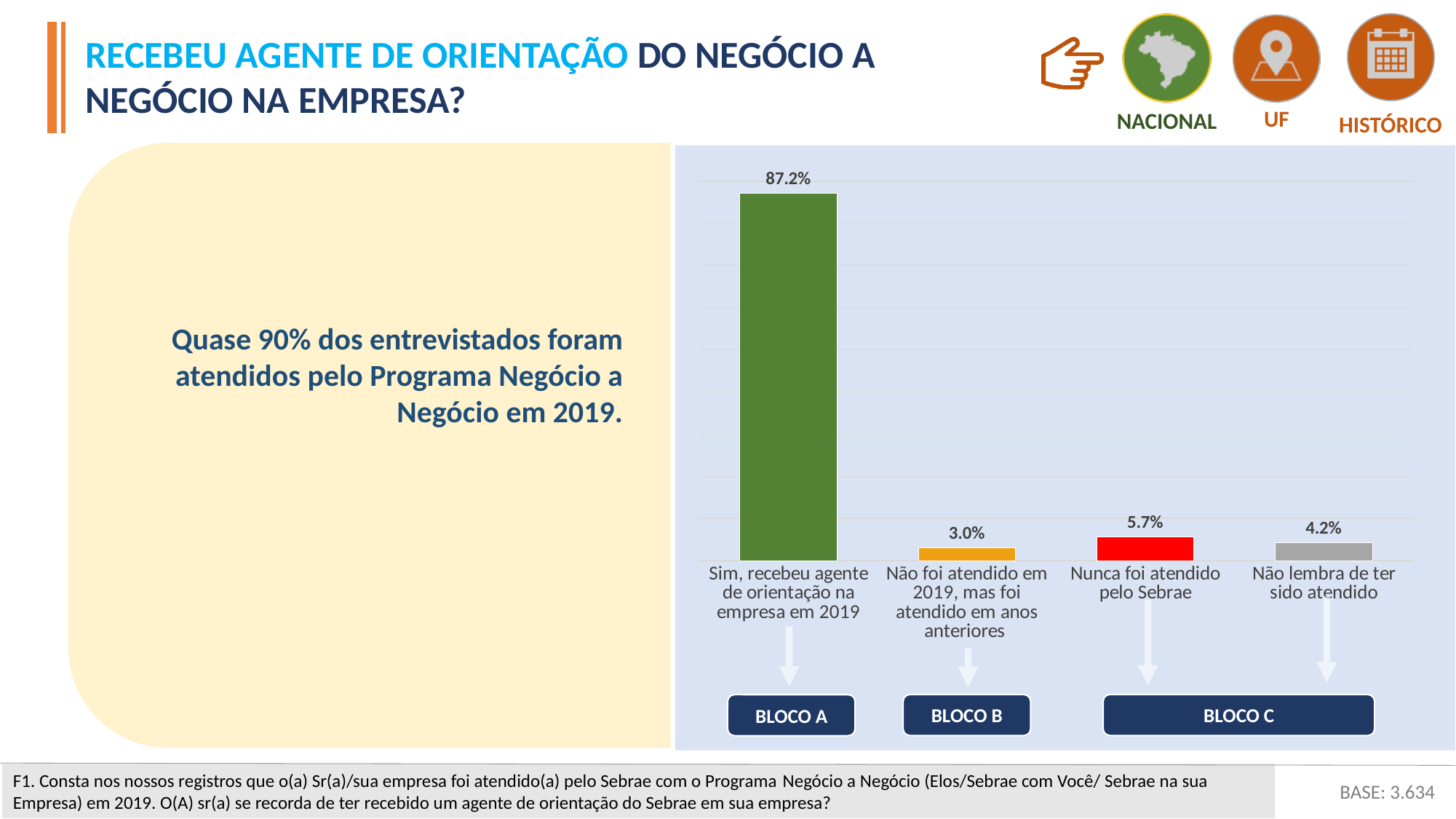
Which category has the lowest value? Não foi atendido em 2019, mas foi atendido em anos anteriores Which bloco label is placed under the bars for "Nunca foi atendido pelo Sebrae" and "Não lembra de ter sido atendido"? BLOCO C What is the value for "Sim, recebeu agente de orientação na empresa em 2019"? 87.2% What is the difference between the values for "Nunca foi atendido pelo Sebrae" and "Não lembra de ter sido atendido"? 1.5% What is the value for "Não lembra de ter sido atendido"? 4.2% What is the value for "Não foi atendido em 2019, mas foi atendido em anos anteriores"? 3.0% Which category has the highest value? Sim, recebeu agente de orientação na empresa em 2019 What colour is the bar for "Nunca foi atendido pelo Sebrae"? Red How many categories are shown in the chart? 4 Which is larger: the value for "Nunca foi atendido pelo Sebrae" or the value for "Não foi atendido em 2019, mas foi atendido em anos anteriores"? Nunca foi atendido pelo Sebrae What kind of chart is shown on the slide? Bar chart What is the value for "Nunca foi atendido pelo Sebrae"? 5.7%